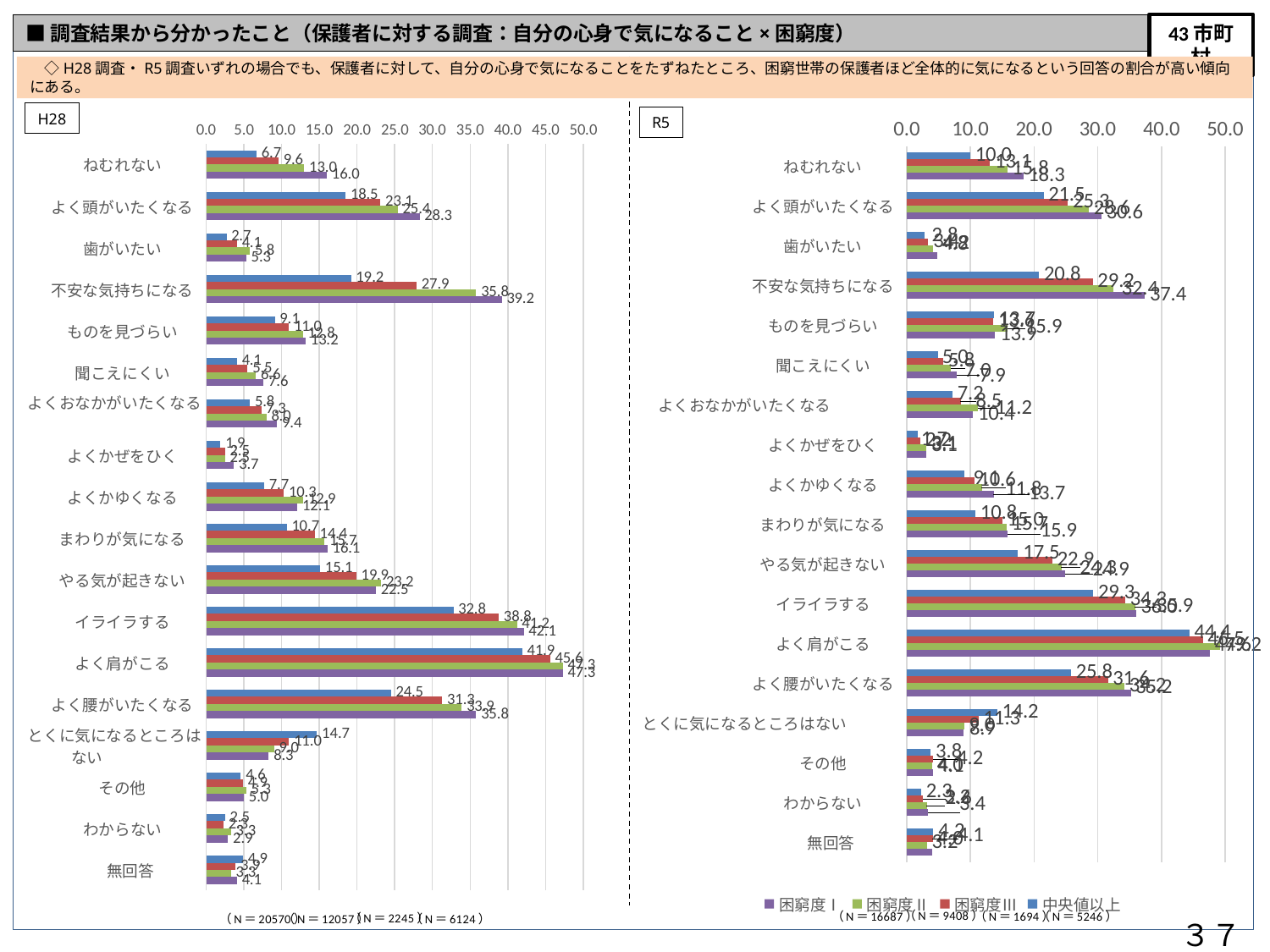
On the H28 chart, which category has the highest value for the 中央値以上 series? よく肩がこる On the R5 chart, what is the value for 困窮度Ⅰ in the 不安な気持ちになる category? 37.4 What kind of chart is the H28 chart on the left? bar chart How many categories are plotted on the H28 chart? 18 On the H28 chart, in the イライラする category, which is larger: 困窮度Ⅰ or 中央値以上? 困窮度Ⅰ On the H28 chart, what is the difference between 困窮度Ⅰ and 中央値以上 in the 不安な気持ちになる category? 20.0 On the R5 chart, what is the value for 中央値以上 in the よく頭がいたくなる category? 21.5 How many series does the legend at the bottom of the slide list? 4 On the H28 chart, what is the value for 中央値以上 in the ねむれない category? 6.7 On the H28 chart, what is the value for 中央値以上 in the とくに気になるところはない category? 14.7 On the H28 chart, what is the value for 困窮度Ⅰ in the 不安な気持ちになる category? 39.2 On the R5 chart, what is the value for 中央値以上 in the ねむれない category? 10.0